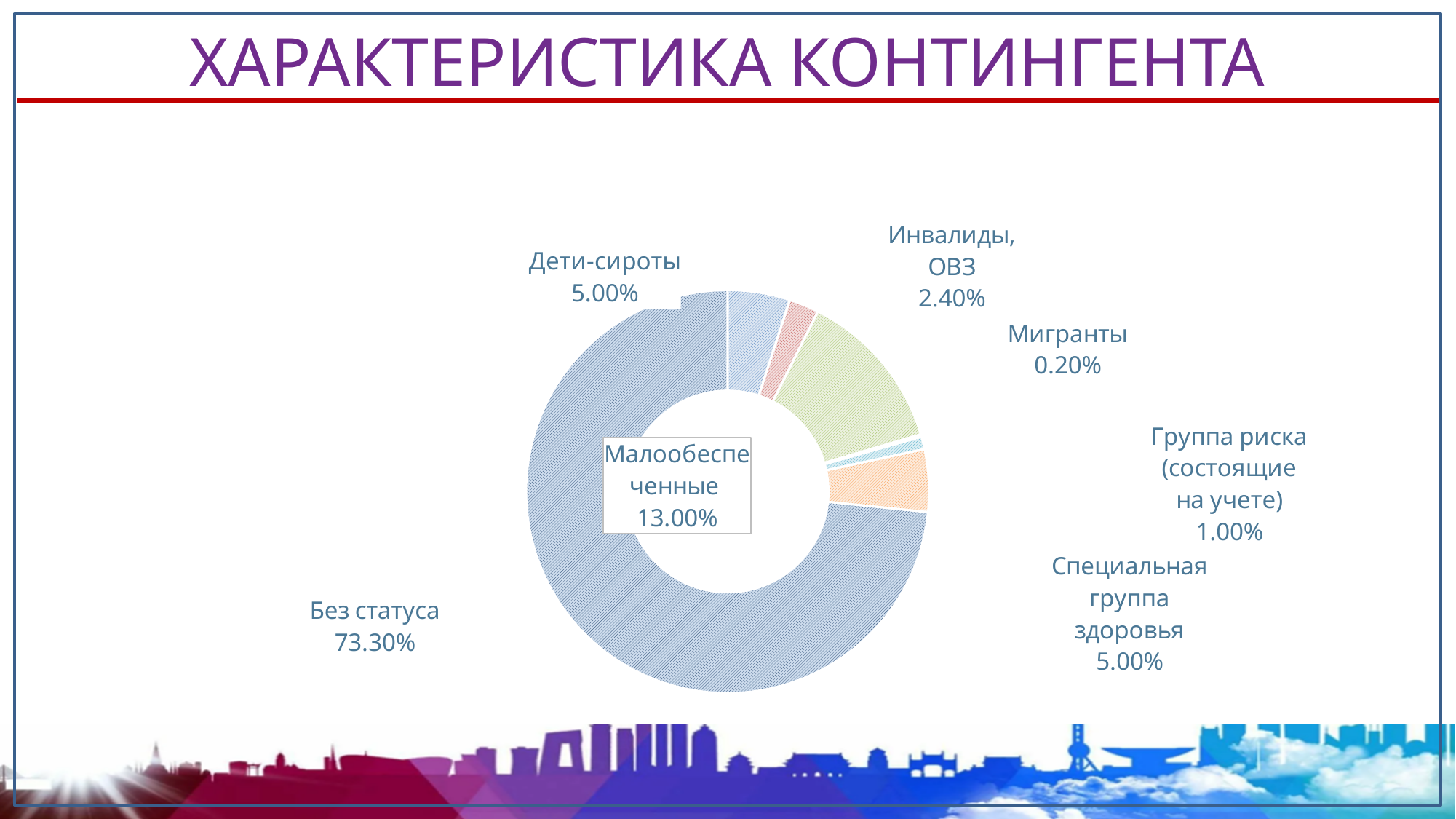
What type of chart is shown on the slide? Pie (doughnut) chart Which category has the smallest share? Мигранты What is the value for Мигранты? 0.20% What is the value for Без статуса? 73.30% What is the value for Группа риска (состоящие на учете)? 1.00% Which is larger, the value for Инвалиды, ОВЗ or the value for Группа риска (состоящие на учете)? Инвалиды, ОВЗ What is the difference between the values for Без статуса and Малообеспеченные? 60.30% Which category has the largest share? Без статуса What is the value for Малообеспеченные? 13.00% What is the value for Инвалиды, ОВЗ? 2.40% How many categories are shown in the chart? 7 What is the title of the slide? ХАРАКТЕРИСТИКА КОНТИНГЕНТА